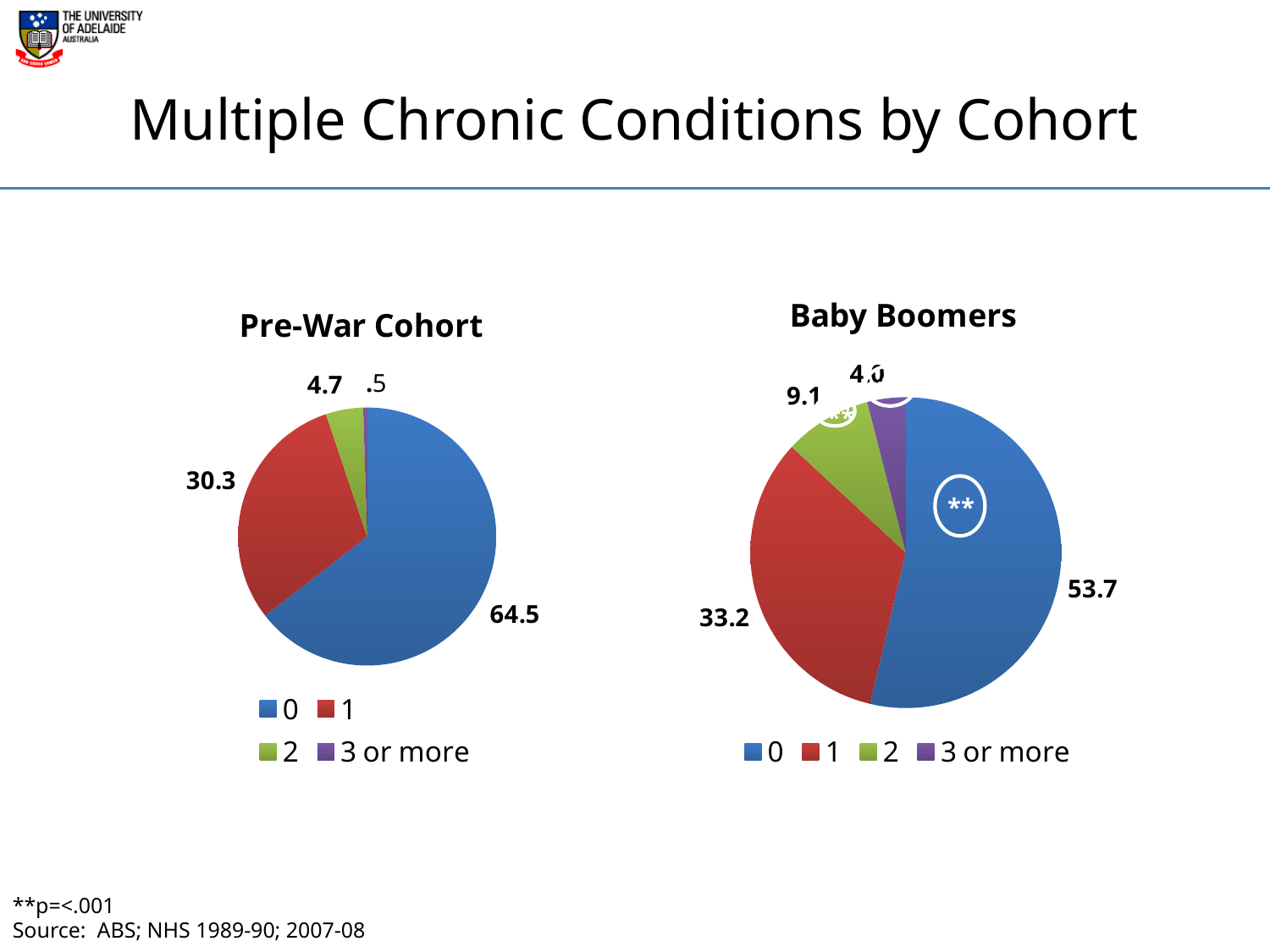
In the Baby Boomers pie chart, what is the difference between the '0' slice and the '1' slice? 20.5 Which is larger: the '0' slice in the Pre-War Cohort chart or the '0' slice in the Baby Boomers chart? Pre-War Cohort In the Pre-War Cohort pie chart, what is the value for the '0' slice? 64.5 In the Baby Boomers pie chart, what is the value for the '0' slice? 53.7 In the Pre-War Cohort pie chart, what is the difference between the '0' slice and the '1' slice? 34.2 In the Pre-War Cohort pie chart, what is the value for the '1' slice? 30.3 In the Baby Boomers pie chart, which category has the largest slice? 0 In the Pre-War Cohort pie chart, what is the value for the '2' slice? 4.7 In the Baby Boomers pie chart, what is the value for the '2' slice? 9.1 How many entries does the legend of the Baby Boomers chart list? 4 What kind of chart is the Pre-War Cohort chart? Pie chart In the Baby Boomers pie chart, what is the value for the '1' slice? 33.2